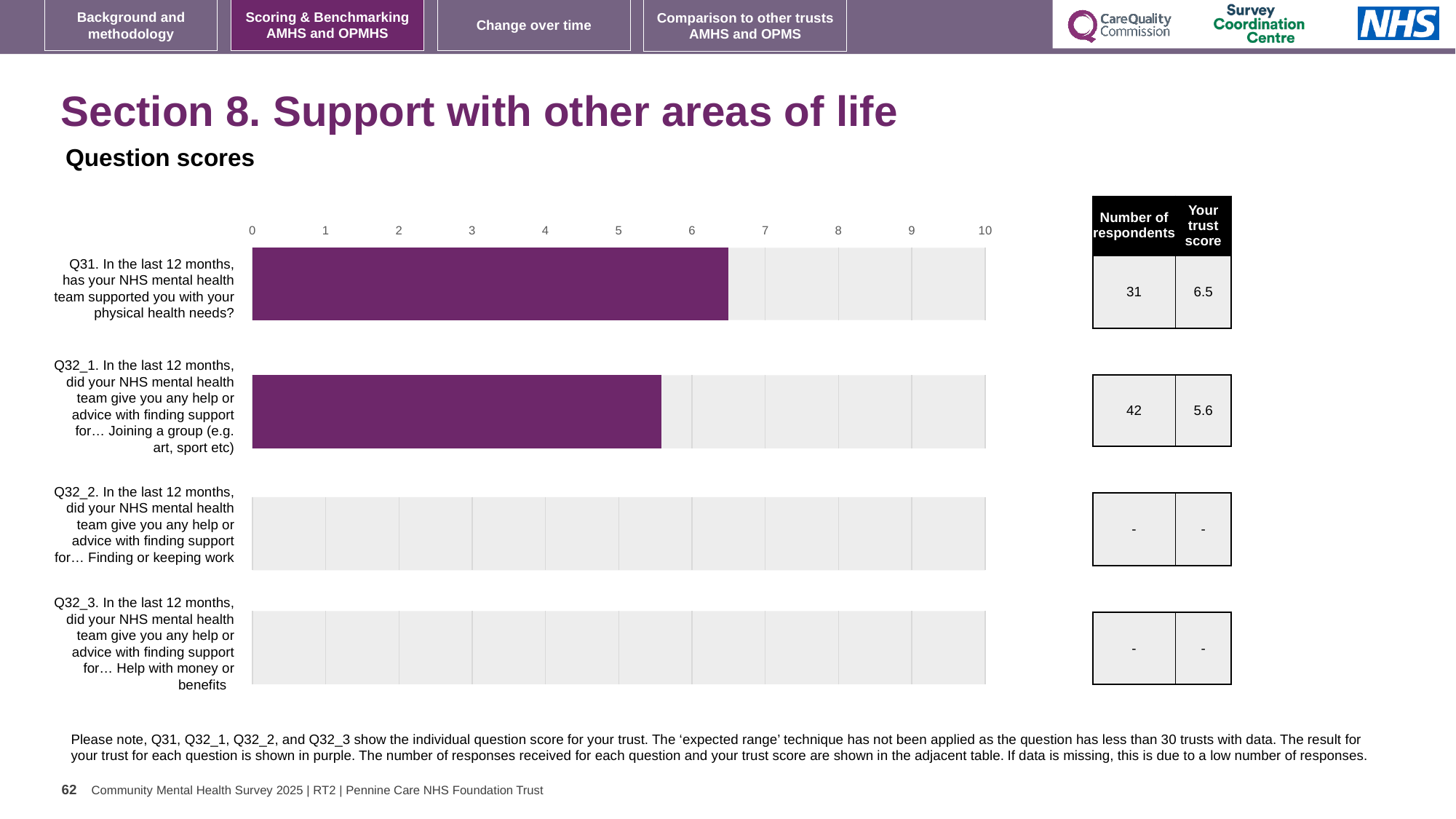
Which question has the highest trust score on the chart? Q31 How many respondents answered Q32_1? 42 How many respondents answered Q31? 31 Is the trust score for Q32_1 greater or less than 6? less What colour are the trust score bars on the chart? Purple Which has the larger trust score, Q31 or Q32_1? Q31 What is the trust score for Q31 (supported you with your physical health needs)? 6.5 What is the difference between the trust scores for Q31 and Q32_1? 0.9 What is the maximum value shown on the chart's axis? 10 What kind of chart is shown on the slide? Bar chart How many questions are listed on the chart? 4 What is the trust score for Q32_1 (help or advice with joining a group)? 5.6